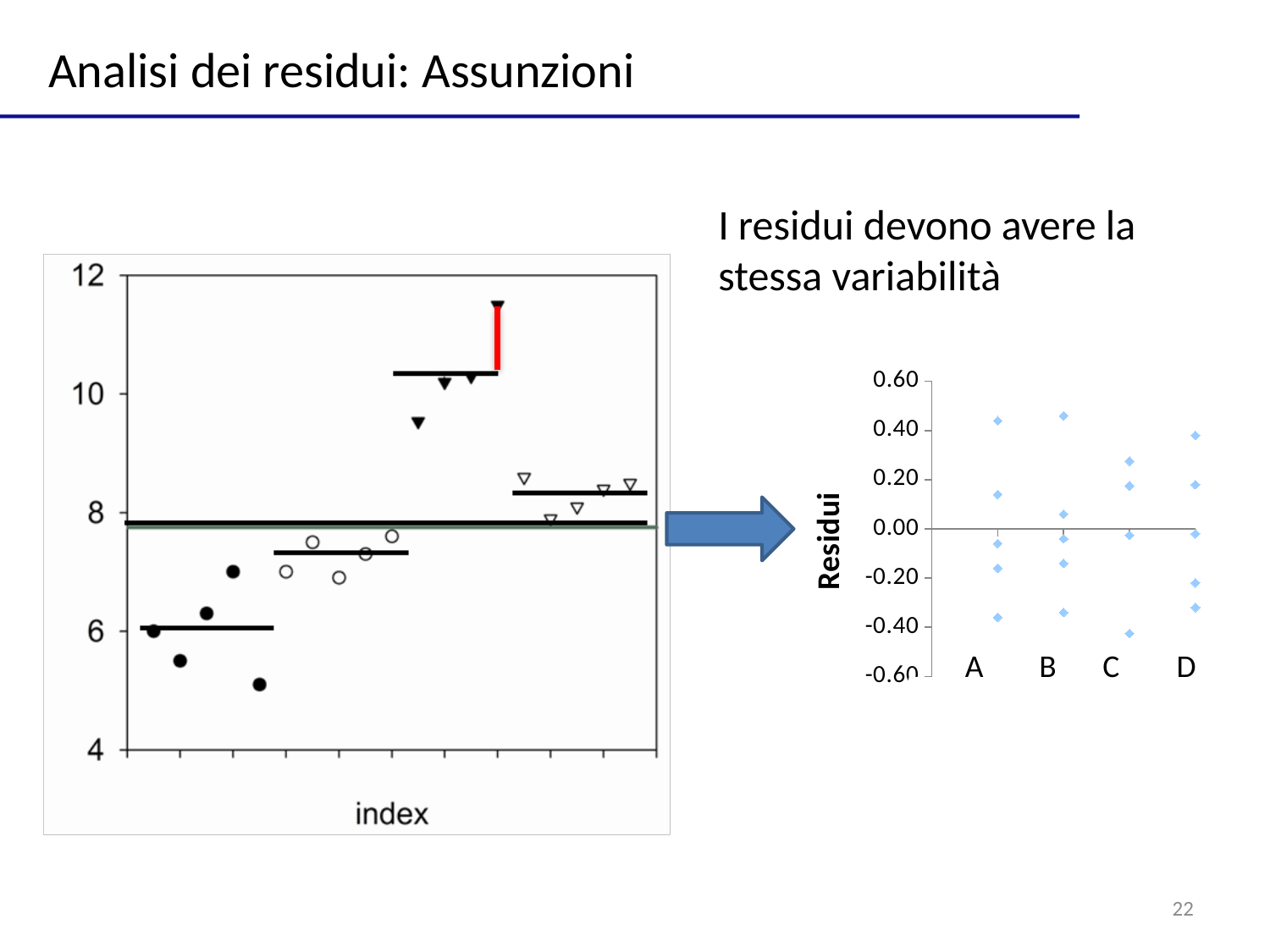
In the right-hand chart, is the lowest point for category D greater or less than -0.40? greater In the left-hand chart, is the highest plotted point greater or less than 10? greater In the left-hand chart, is the long horizontal line spanning the whole plot greater or less than 8? less In the left-hand chart, what is the label of the horizontal axis? index In the right-hand chart, how many categories are shown on the horizontal axis? 4 What kind of chart is the right-hand chart with categories A, B, C and D? scatter chart What kind of chart is the left-hand chart with the x axis labelled index? scatter chart In the right-hand chart, what is the title of the vertical axis? Residui